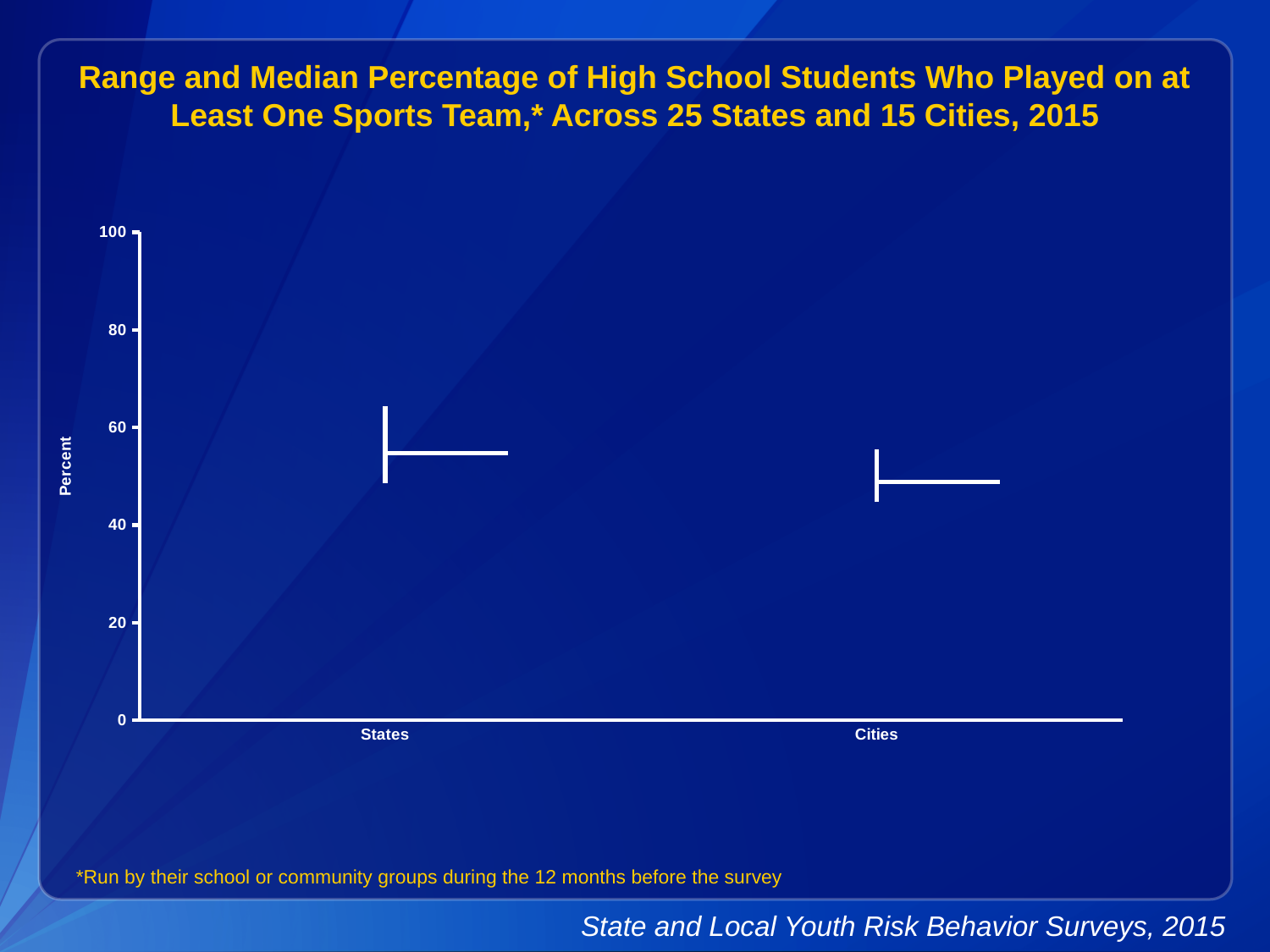
Is the top of the range for States greater or less than 60? greater Is the median value for Cities greater or less than 60? less What is the highest value shown on the y axis? 100 What is the label on the y axis of the chart? Percent How many categories are shown on the x axis of the chart? 2 What are the two categories shown on the x axis? States and Cities Which category has the lowest median value? Cities Is the bottom of the range for Cities greater or less than 40? greater Which category has the higher median value, States or Cities? States